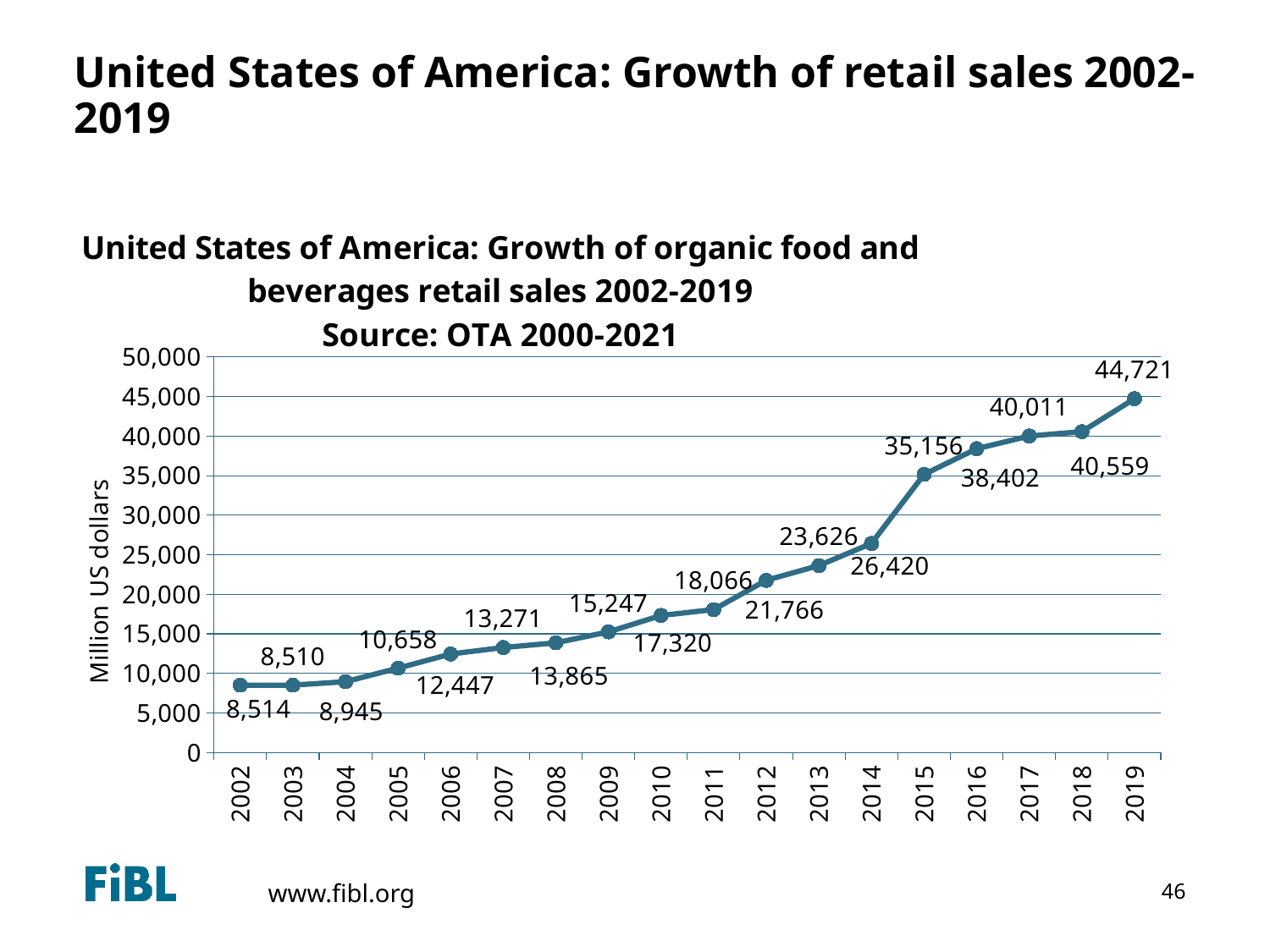
What type of chart is shown on the slide? Line chart Is the value for 2016 greater or less than 30,000? greater What is the difference between the retail sales values for 2015 and 2014? 8,736 Which year has the lowest retail sales value? 2003 How many years are plotted on the chart? 18 Which year has the highest retail sales value? 2019 What was the value of organic food and beverages retail sales in 2010? 17,320 What was the value of organic food and beverages retail sales in 2019? 44,721 Which year has a larger retail sales value, 2012 or 2009? 2012 What was the value of organic food and beverages retail sales in 2002? 8,514 What is the difference between the retail sales values for 2019 and 2002? 36,207 What was the value of organic food and beverages retail sales in 2015? 35,156